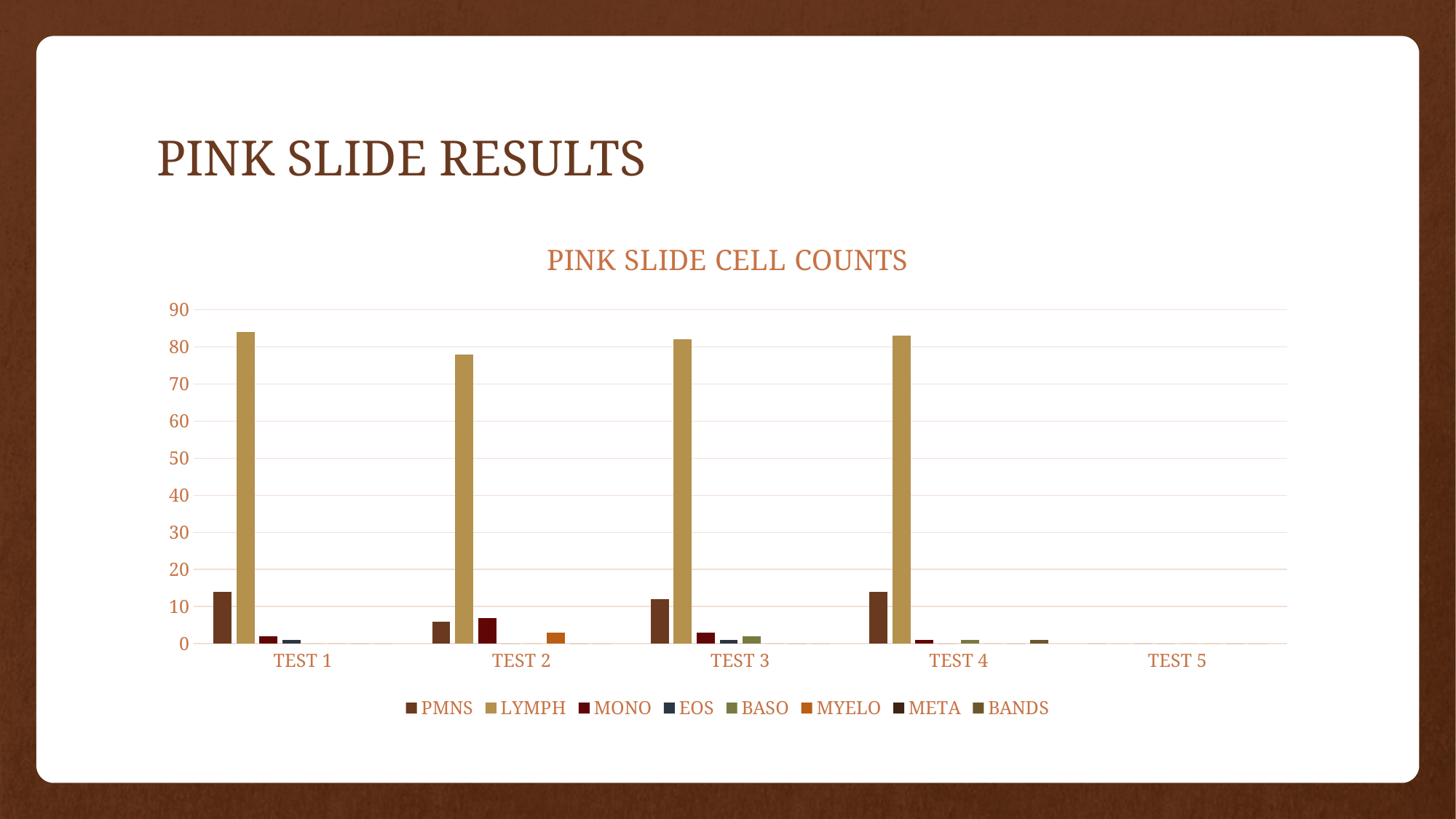
What kind of chart is shown on the slide? bar chart Among TEST 1 through TEST 4, which test has the lowest LYMPH value? TEST 2 Is the LYMPH value for TEST 2 greater or less than 70? greater How many test categories are shown on the x axis of the chart? 5 Which is larger, the MONO value for TEST 1 or the MONO value for TEST 2? TEST 2 Which is larger, the PMNS value for TEST 1 or the PMNS value for TEST 2? TEST 1 How many series does the legend of the chart list? 8 In which test does the MYELO series have a visible bar? TEST 2 Which series has the highest value in TEST 1? LYMPH What is the title of the chart? PINK SLIDE CELL COUNTS Is the LYMPH value for TEST 1 greater or less than 80? greater Is the PMNS value for TEST 1 greater or less than 20? less